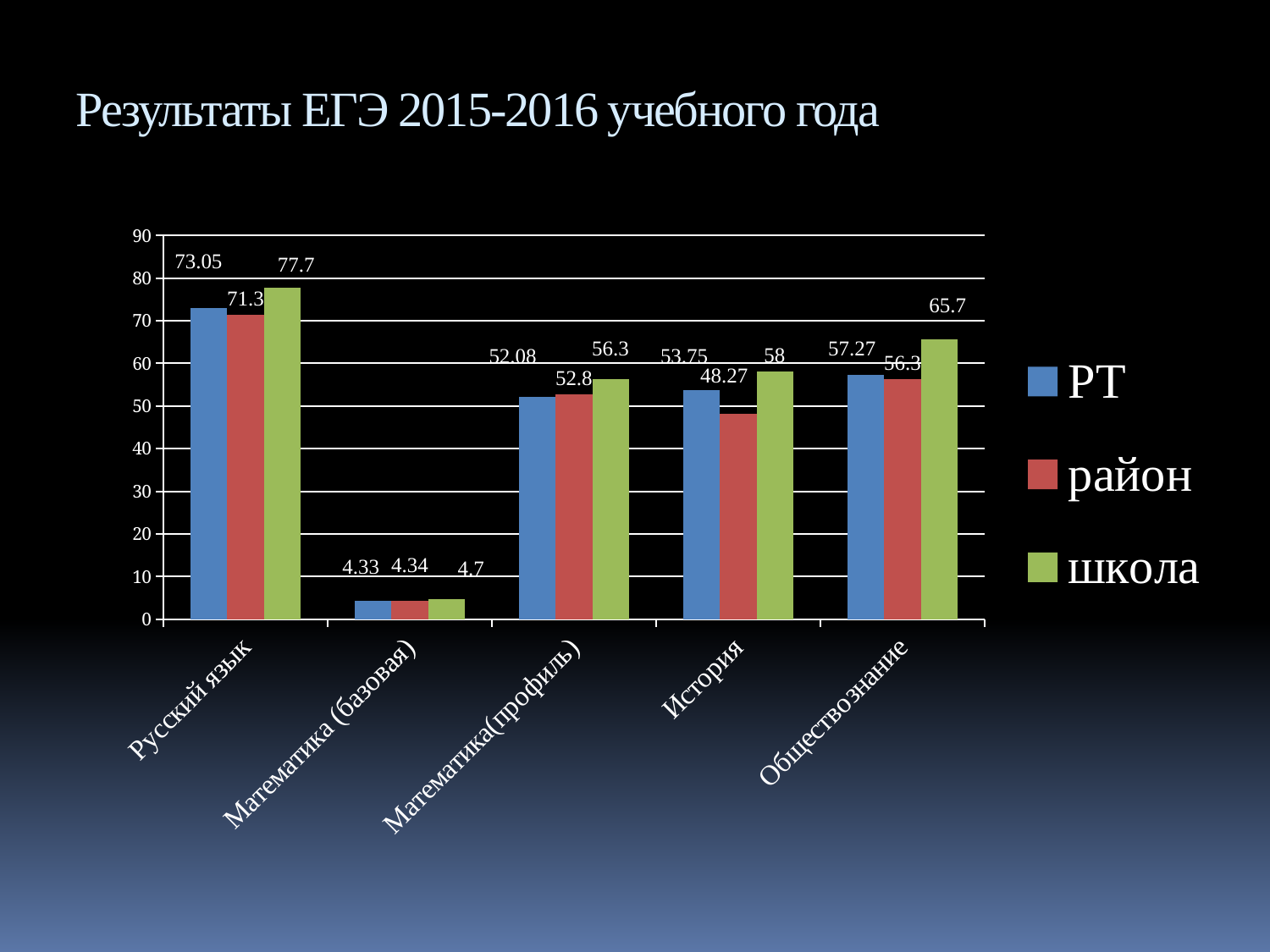
Which category has the highest value for школа? Русский язык Which is larger in Обществознание: the РТ value or the школа value? школа How many categories are shown on the x axis? 5 What is the value for район in Обществознание? 56.3 What is the title of the slide? Результаты ЕГЭ 2015-2016 учебного года What is the value for школа in Русский язык? 77.7 What is the difference between the школа and район values for История? 9.73 Is the value for район in Математика(профиль) greater or less than 50? greater What kind of chart is shown on the slide? bar chart Which category has the lowest value for РТ? Математика (базовая) How many series does the legend list? 3 What is the value for РТ in История? 53.75